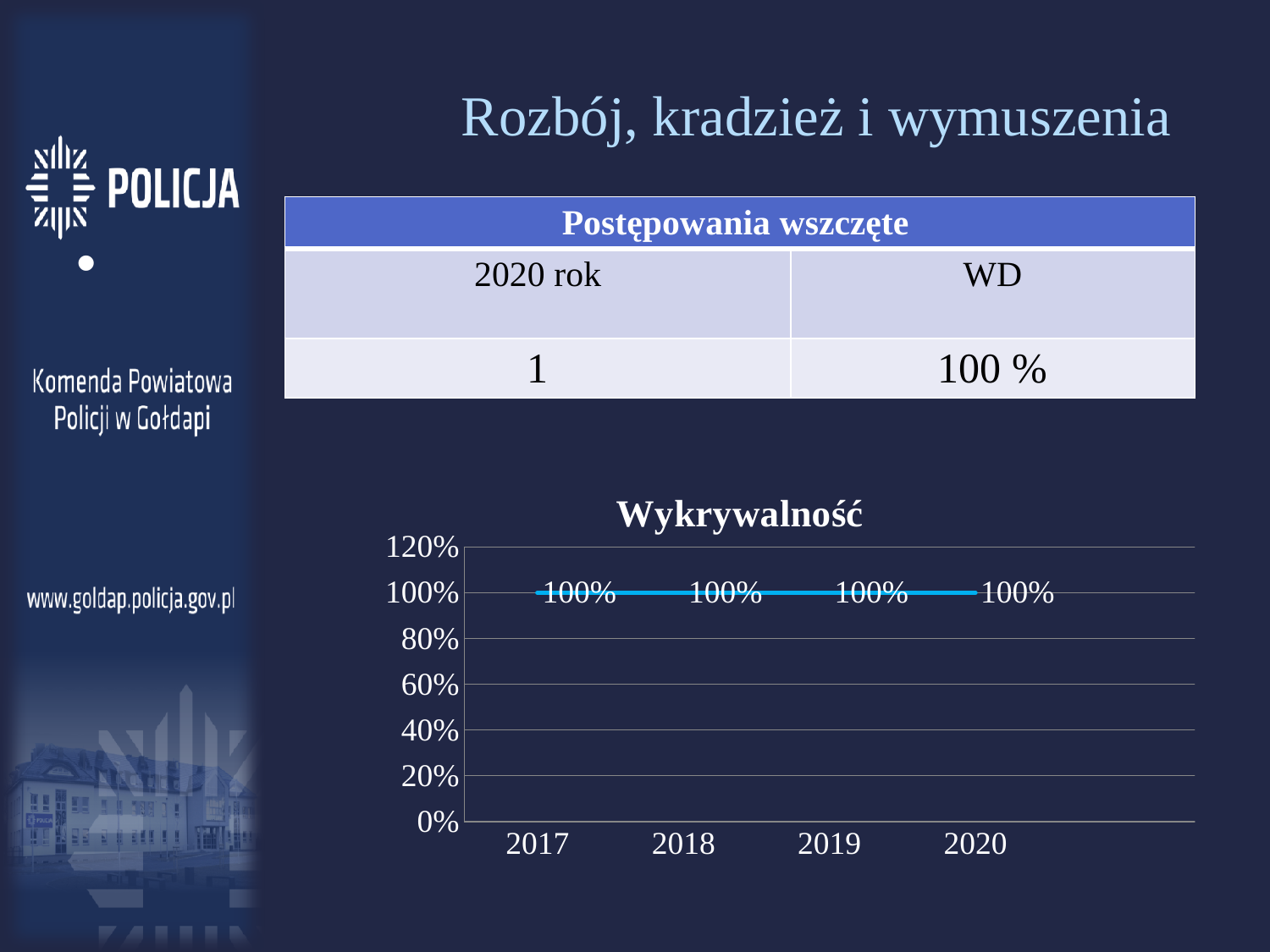
What is the title of the chart on the slide? Wykrywalność What is the value for 2020 in the Wykrywalność chart? 100% What is the value for 2018 in the Wykrywalność chart? 100% What is the highest value shown on the y axis of the Wykrywalność chart? 120% What is the value for 2017 in the Wykrywalność chart? 100% What is the value for 2019 in the Wykrywalność chart? 100% How many years are plotted on the x axis of the Wykrywalność chart? 4 Is the value for 2019 in the Wykrywalność chart greater or less than 80%? greater What kind of chart is the Wykrywalność chart? line chart Is the value for 2017 in the Wykrywalność chart greater or less than 120%? less What is the difference between the values for 2017 and 2020 in the Wykrywalność chart? 0% Do the values in the Wykrywalność chart rise, fall, or stay the same from 2017 to 2020? stay the same